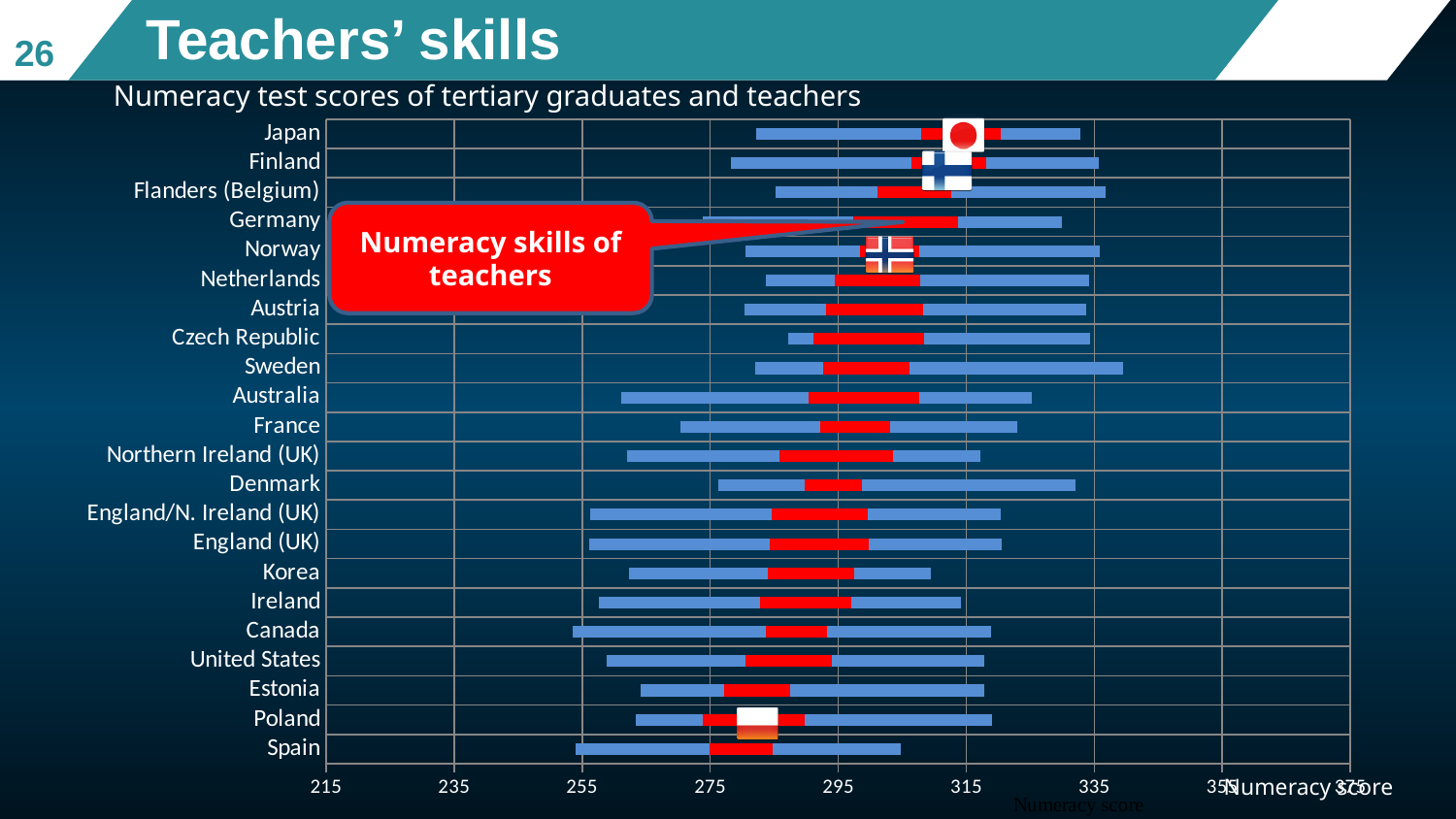
Is the right end of the blue bar for Korea greater or less than 315? less Which country's blue bar extends furthest to the right on the chart? Sweden What does the red callout on the chart say the red bars represent? Numeracy skills of teachers Is the teachers' (red) numeracy score range for Spain greater or less than 295? less What is the title of the chart? Numeracy test scores of tertiary graduates and teachers Is the teachers' (red) numeracy score range for Japan greater or less than 295? greater Which country's red (teachers) bar is positioned furthest to the right on the chart? Japan What kind of chart is shown on the slide? bar chart How many countries or regions are listed on the chart? 22 Which has a higher teachers' (red) numeracy score range, Japan or Spain? Japan